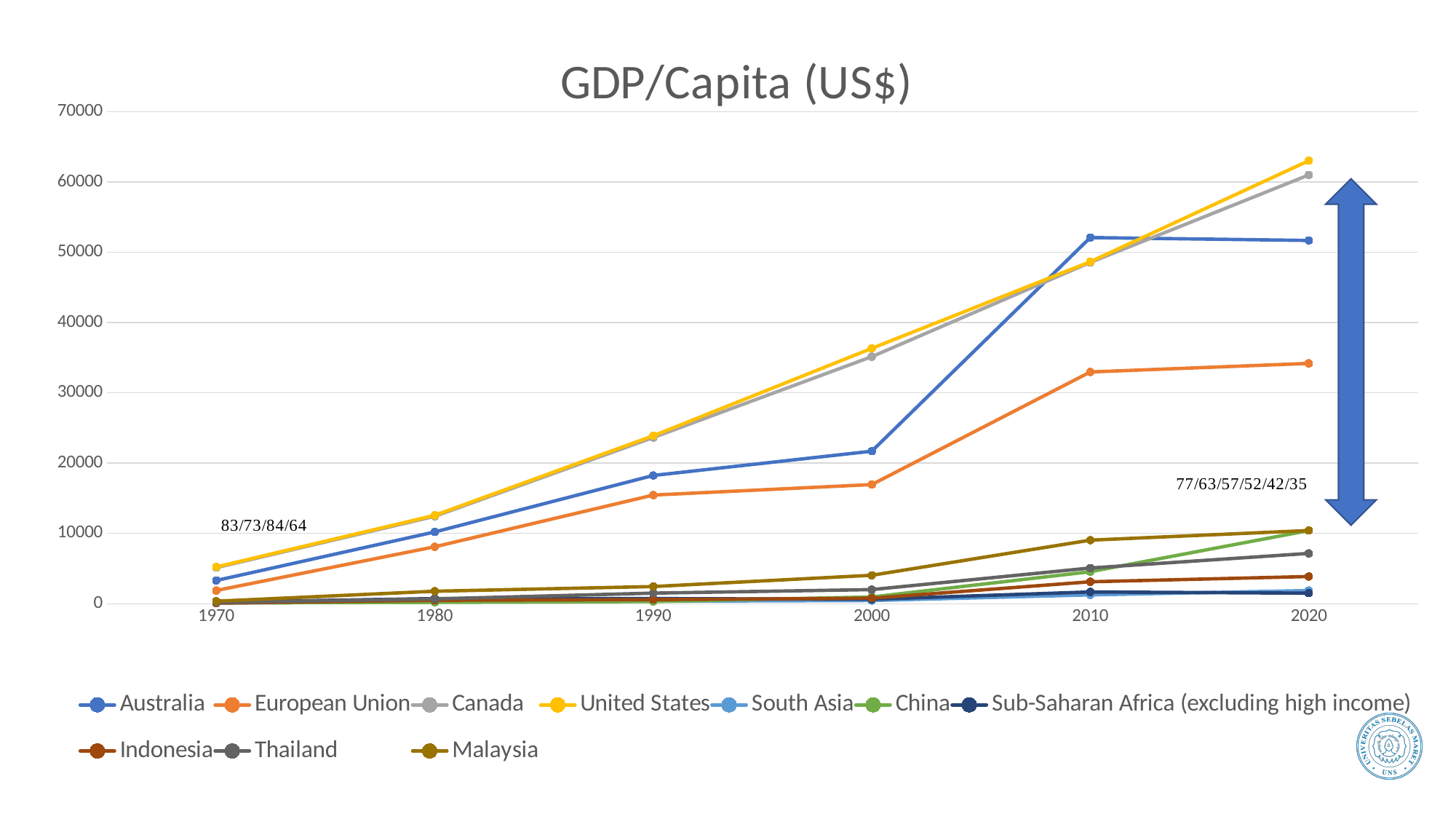
How many series does the legend list? 10 Is the value for European Union in 2020 greater or less than 30000? greater How many years are plotted along the x axis? 6 Does the United States line rise or fall from 1970 to 2020? rise What type of chart is shown on the slide? line chart Which legend entry mentions excluding high income? Sub-Saharan Africa (excluding high income) Is the value for Canada in 2000 greater or less than 40000? less What is the title of the chart? GDP/Capita (US$) In 2020, which is larger: Australia or European Union? Australia Is the value for Australia in 2010 greater or less than 50000? greater Which series has the highest value in 2010? Australia